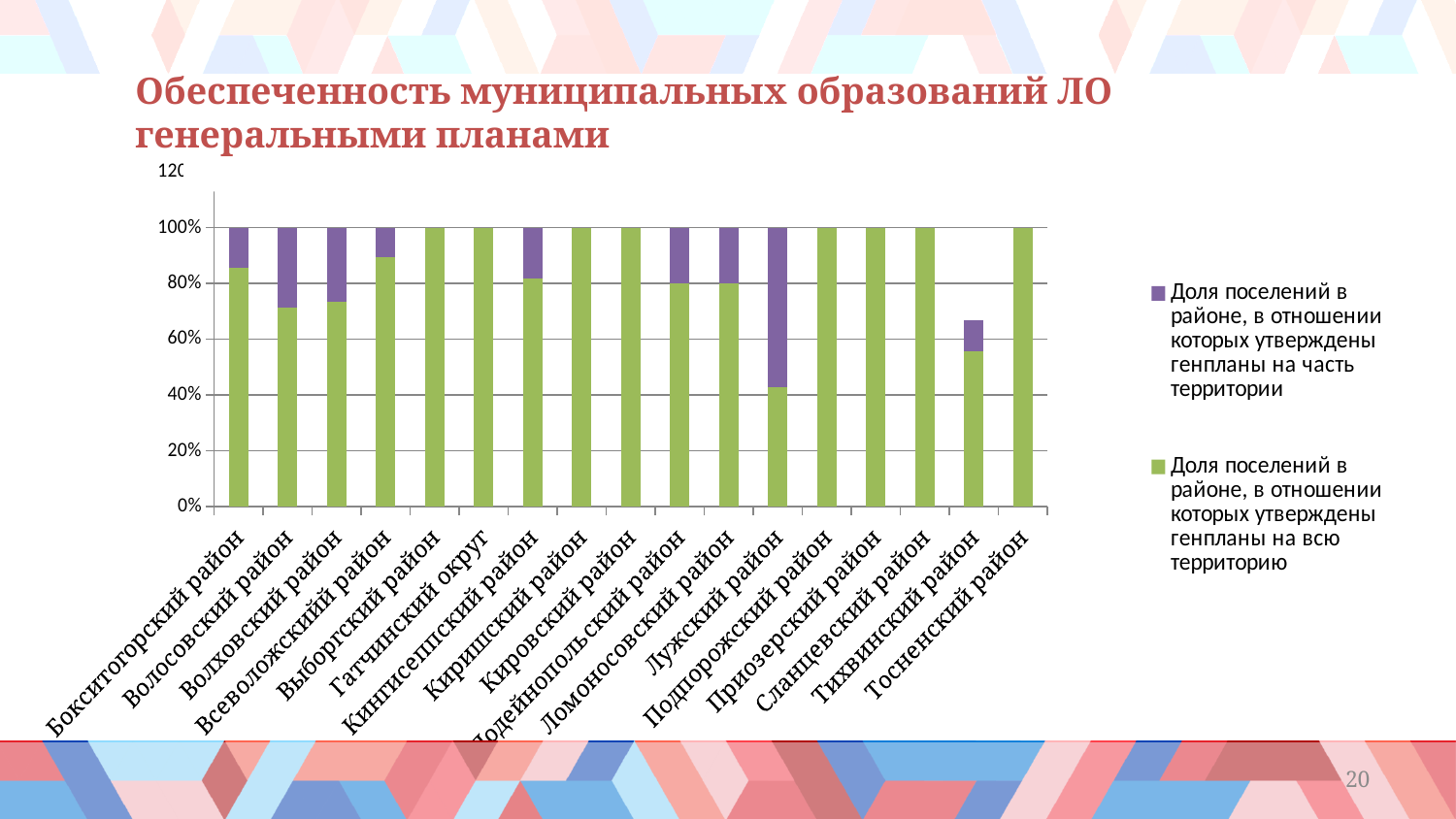
Which district has the lowest green value (general plans for the whole territory)? Лужский район Is the green value (general plans for the whole territory) for Лужский район greater or less than 60%? less Is the green value (general plans for the whole territory) for Бокситогорский район greater or less than 80%? greater Which has the larger green value (general plans for the whole territory): Бокситогорский район or Волосовский район? Бокситогорский район What kind of chart is shown on the slide? stacked bar chart Is the total bar height for Тихвинский район greater or less than 80%? less Which district has the lowest total bar height? Тихвинский район How many districts (categories) are shown along the x axis? 17 Which colour represents the share of settlements with general plans approved for the whole territory? green How many series does the legend list? 2 What is the value for Выборгский район for the share of settlements with general plans approved for the whole territory (green series)? 100% Which has the larger green value (general plans for the whole territory): Всеволожский район or Волховский район? Всеволожский район